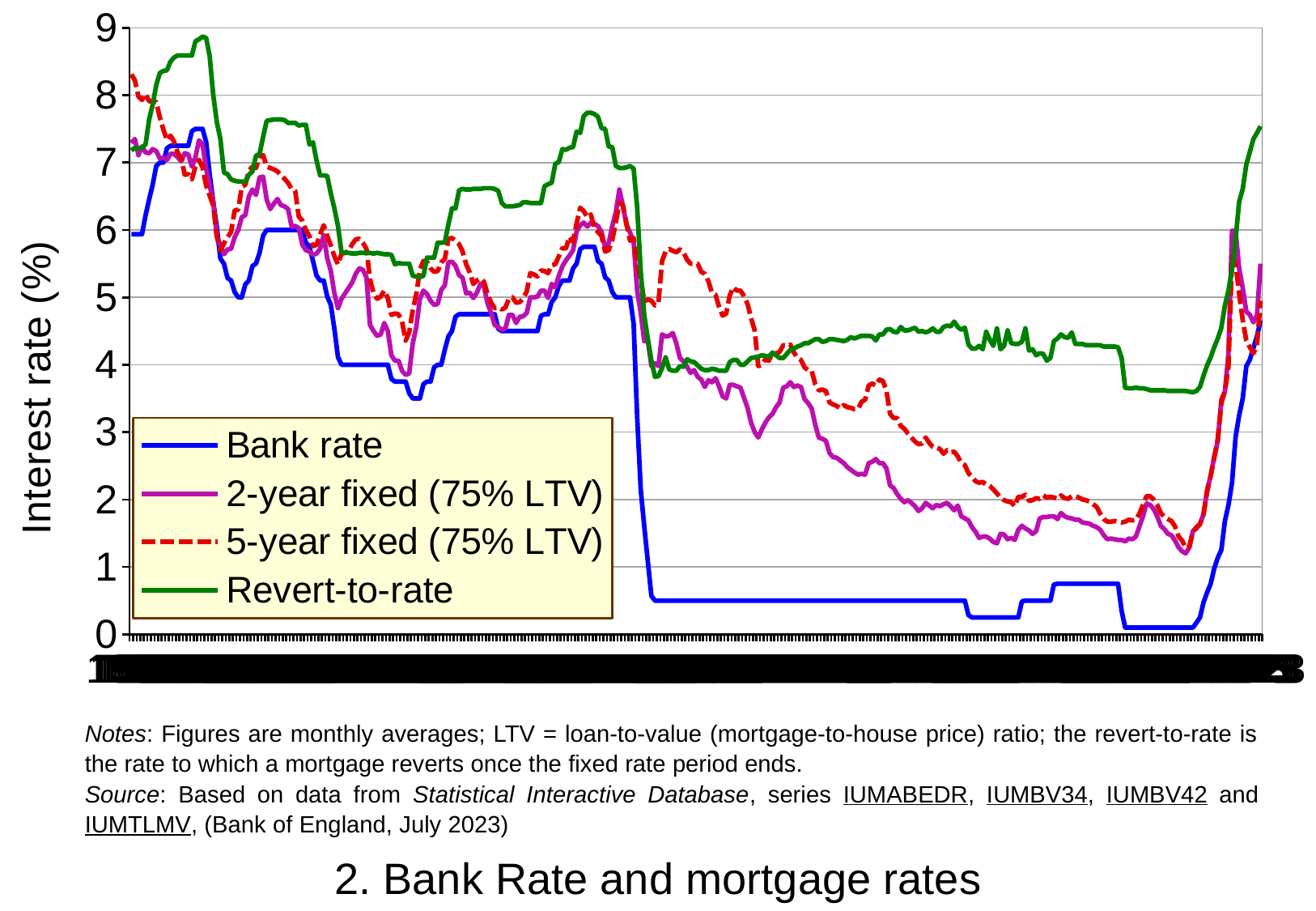
Is the lowest value of the Revert-to-rate line greater or less than 3? greater Which series reaches the lowest value anywhere on the chart? Bank rate What is the title of the chart? 2. Bank Rate and mortgage rates Is the lowest value of the 2-year fixed (75% LTV) line greater or less than 2? less Which series is drawn as a dashed line? 5-year fixed (75% LTV) What kind of chart is shown on the slide? Line chart Is the lowest value of the Bank rate line greater or less than 1? less How many series does the legend list? 4 Which series reaches the highest value anywhere on the chart? Revert-to-rate